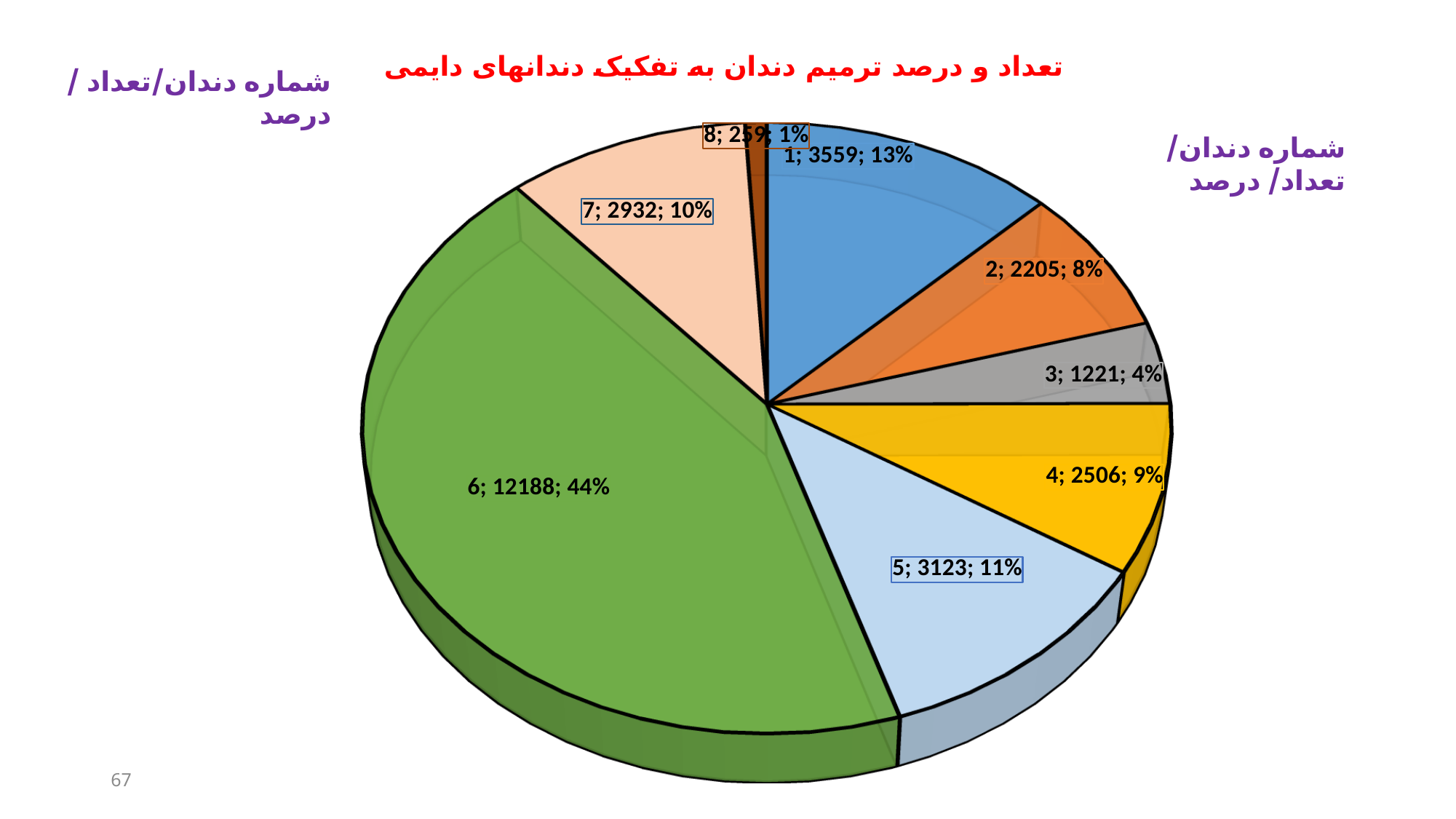
What colour is the slice for tooth number 6? green What is the count shown for tooth number 6? 12188 What is the difference between the counts for tooth number 5 and tooth number 4? 617 What is the count shown for tooth number 8? 259 What is the count shown for tooth number 1? 3559 Which tooth number has the smallest slice in the pie chart? 8 What percentage share does tooth number 6 have in the pie chart? 44% How many slices does the pie chart have? 8 What percentage is shown for tooth number 3? 4% Which tooth number has the largest slice in the pie chart? 6 What kind of chart is shown on the slide? pie chart Which has a larger count, tooth number 2 or tooth number 7? tooth number 7